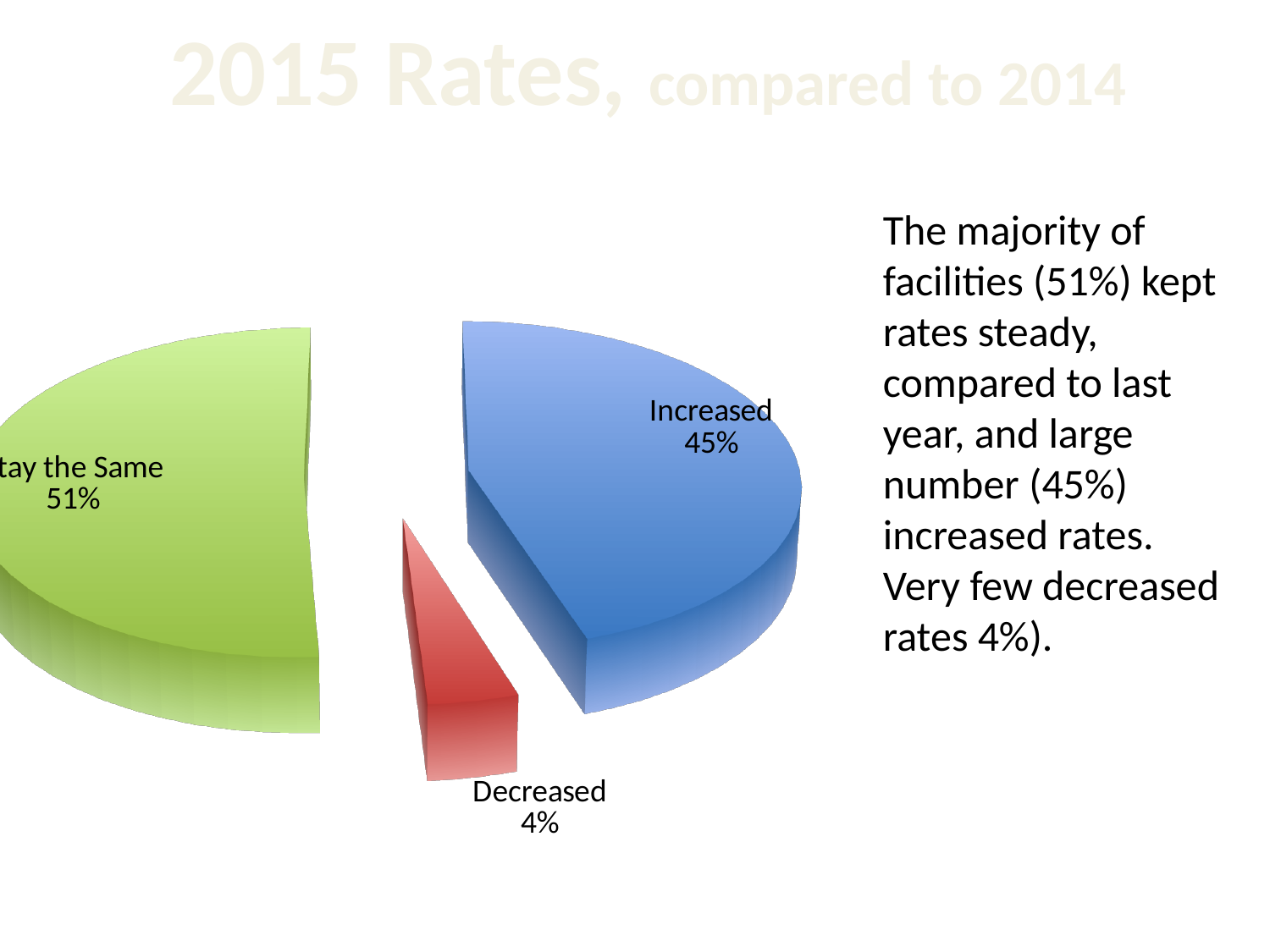
How many slices does the pie chart have? 3 What kind of chart is shown on the slide? Pie chart What is the difference in percentage points between the Increased slice and the Decreased slice? 41 What share of the pie is labelled Decreased? 4% What is the difference in percentage points between the Stay the Same slice and the Increased slice? 6 What share of the pie is labelled Increased? 45% What is the title of the slide containing the pie chart? 2015 Rates, compared to 2014 Which is larger, the Increased slice or the Decreased slice? Increased What share of the pie does the green slice (Stay the Same) represent? 51% Which slice of the pie is the smallest? Decreased What colour is the Decreased slice of the pie? Red Which slice of the pie is the largest? Stay the Same